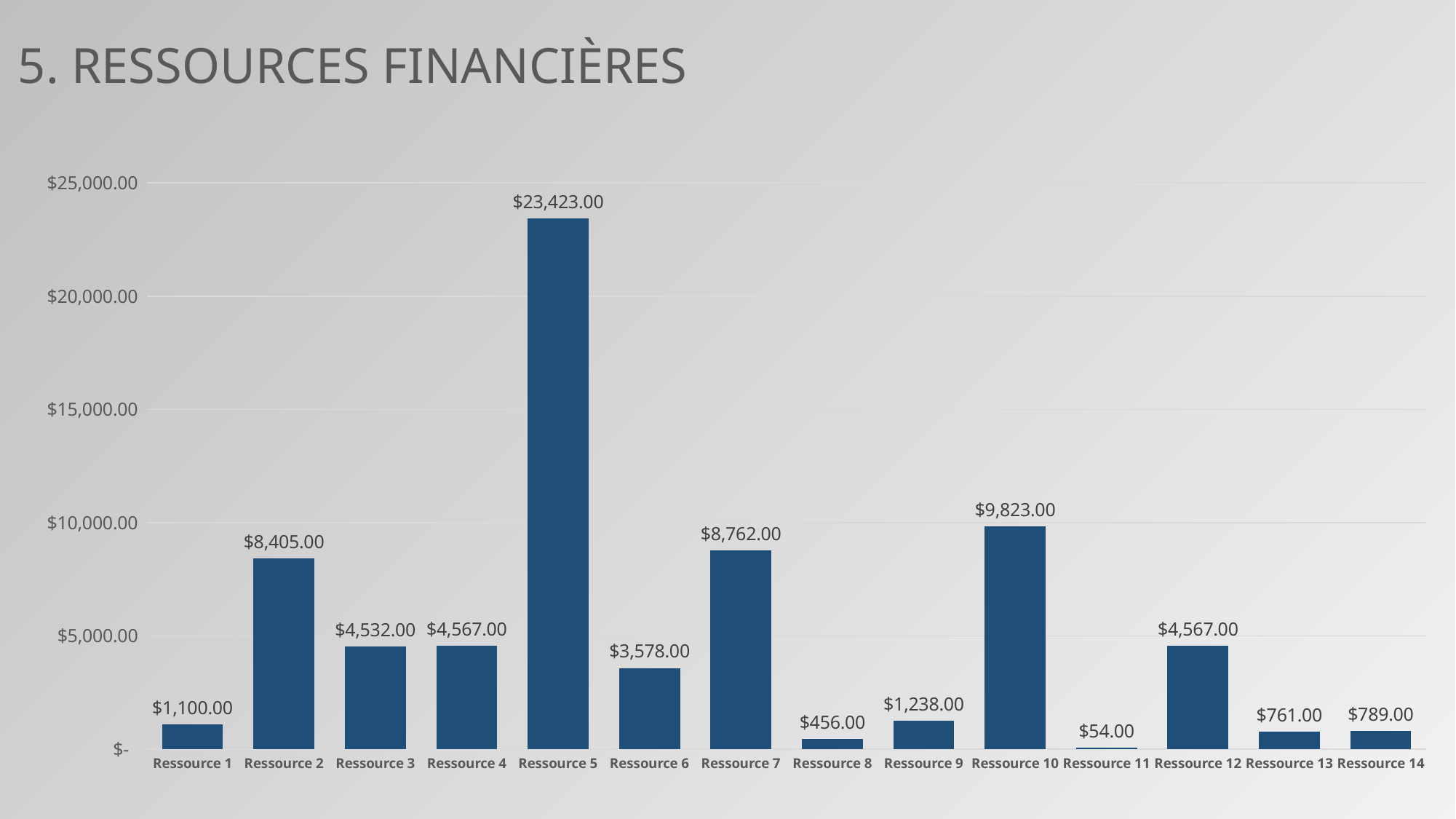
What is the value for Ressource 10? $9,823.00 What is the title of the slide? 5. RESSOURCES FINANCIÈRES Which category has the highest value? Ressource 5 How many categories are shown on the x axis? 14 What is the value for Ressource 5? $23,423.00 Which category has the lowest value? Ressource 11 Which is larger, the value for Ressource 13 or Ressource 14? Ressource 14 Is the value for Ressource 10 greater or less than $10,000.00? less What is the value for Ressource 11? $54.00 What kind of chart is shown on the slide? bar chart What is the difference between the values for Ressource 2 and Ressource 7? $357.00 What is the difference between the values for Ressource 5 and Ressource 10? $13,600.00